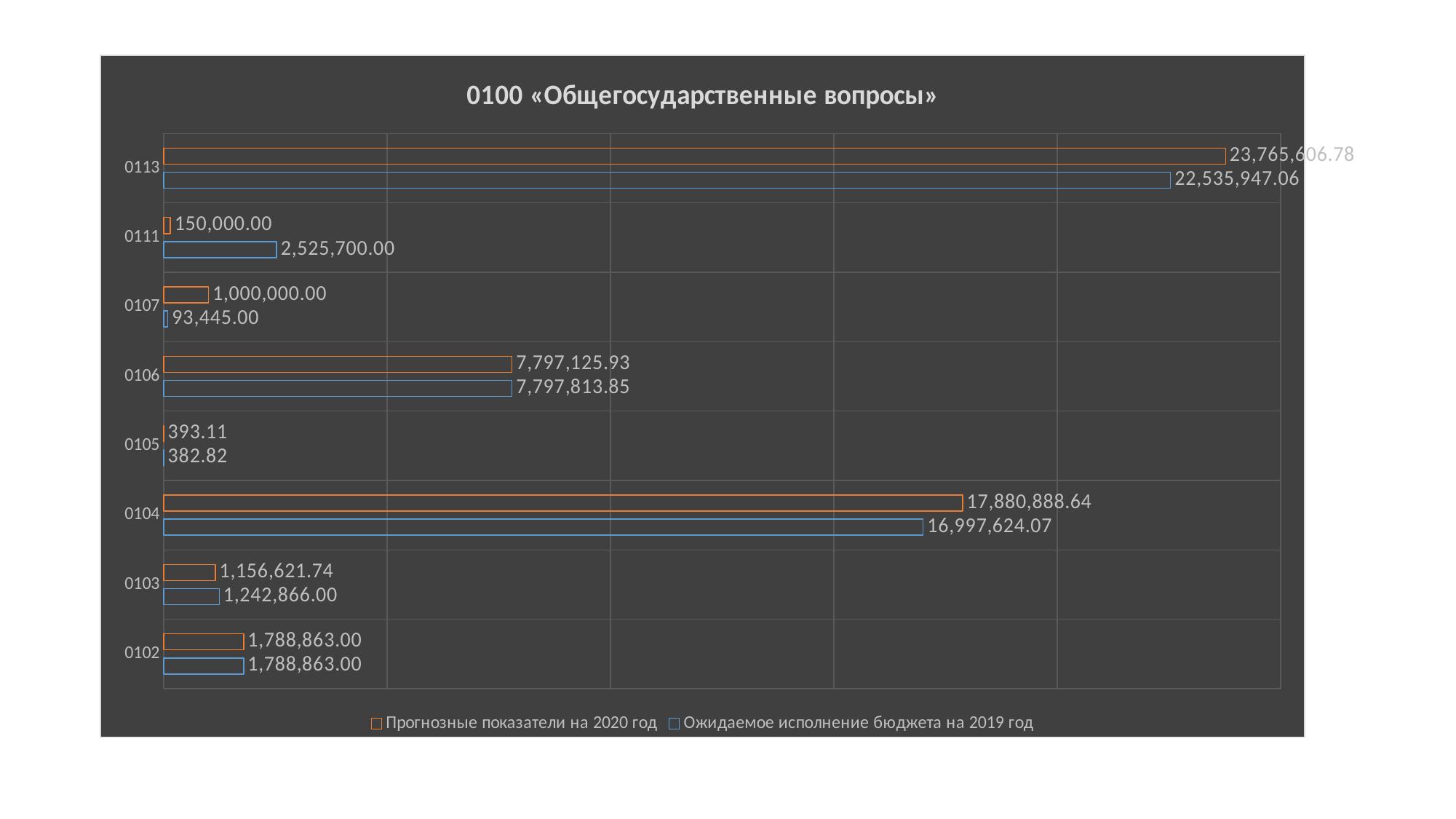
What is the value of «Ожидаемое исполнение бюджета на 2019 год» for category 0113? 22,535,947.06 What is the title of the chart? 0100 «Общегосударственные вопросы» For category 0107, which series has the larger value: «Прогнозные показатели на 2020 год» or «Ожидаемое исполнение бюджета на 2019 год»? Прогнозные показатели на 2020 год What is the value of «Прогнозные показатели на 2020 год» for category 0104? 17,880,888.64 What is the value of «Ожидаемое исполнение бюджета на 2019 год» for category 0111? 2,525,700.00 What kind of chart is shown on the slide? bar chart Which category has the highest value for «Прогнозные показатели на 2020 год»? 0113 How many series does the legend list? 2 What is the value of «Прогнозные показатели на 2020 год» for category 0105? 393.11 How many categories are shown on the vertical axis? 8 What is the difference between «Прогнозные показатели на 2020 год» and «Ожидаемое исполнение бюджета на 2019 год» for category 0104? 883,264.57 Which category has the lowest value for «Ожидаемое исполнение бюджета на 2019 год»? 0105